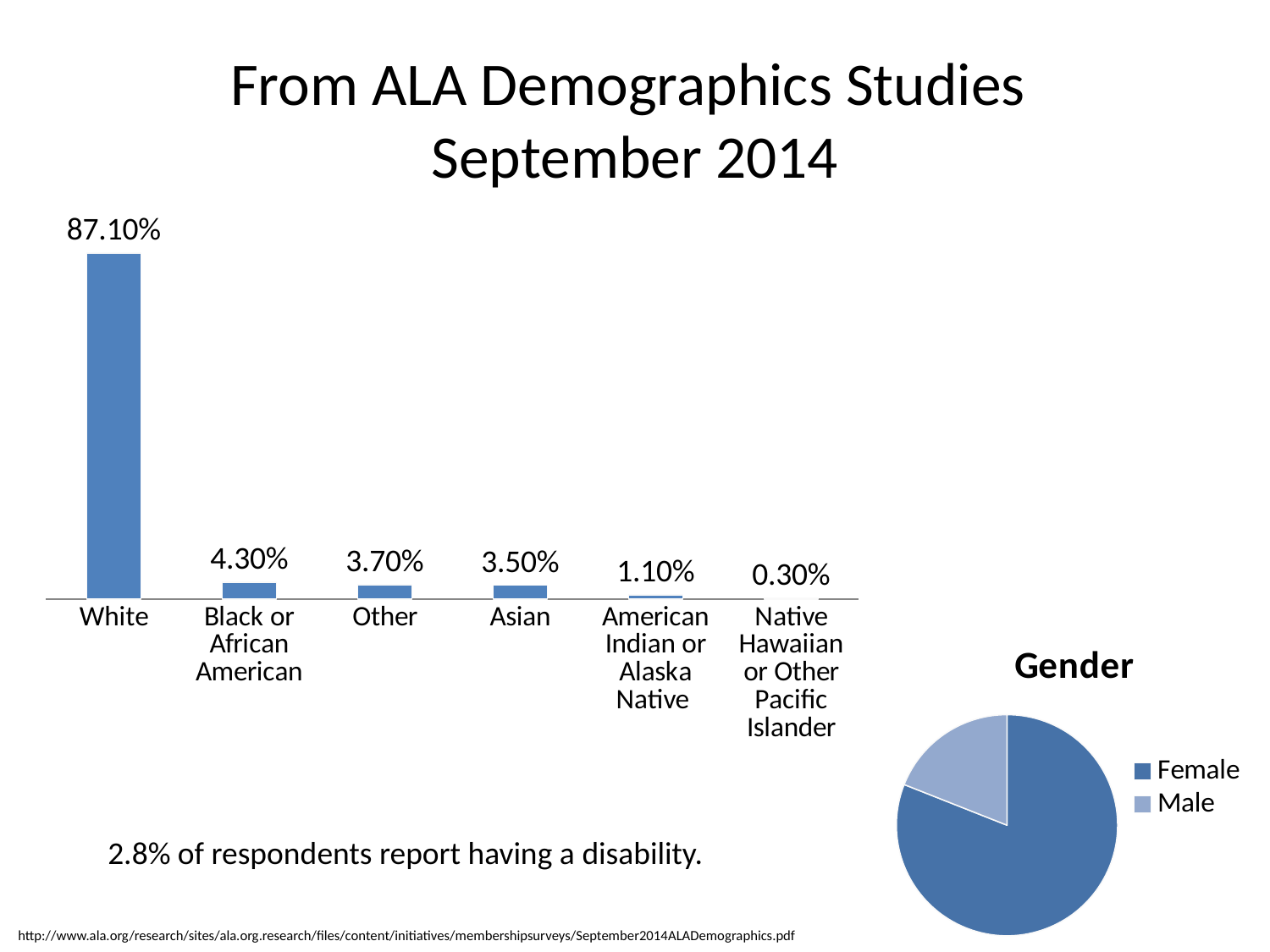
How many categories are shown in the bar chart on the left? 6 In the bar chart on the left, which category has the lowest value? Native Hawaiian or Other Pacific Islander In the bar chart on the left, which is larger: the value for Other or the value for American Indian or Alaska Native? Other In the bar chart on the left, what is the value for White? 87.10% In the bar chart on the left, what is the value for Native Hawaiian or Other Pacific Islander? 0.30% In the bar chart on the left, what is the value for Asian? 3.50% What kind of chart is the chart on the left of the slide? Bar chart In the bar chart on the left, which category has the highest value? White What kind of chart is the Gender chart? Pie chart In the Gender chart, which slice is larger: Female or Male? Female How many entries does the legend of the Gender chart list? 2 In the bar chart on the left, what is the difference between the values for Black or African American and Other? 0.60%